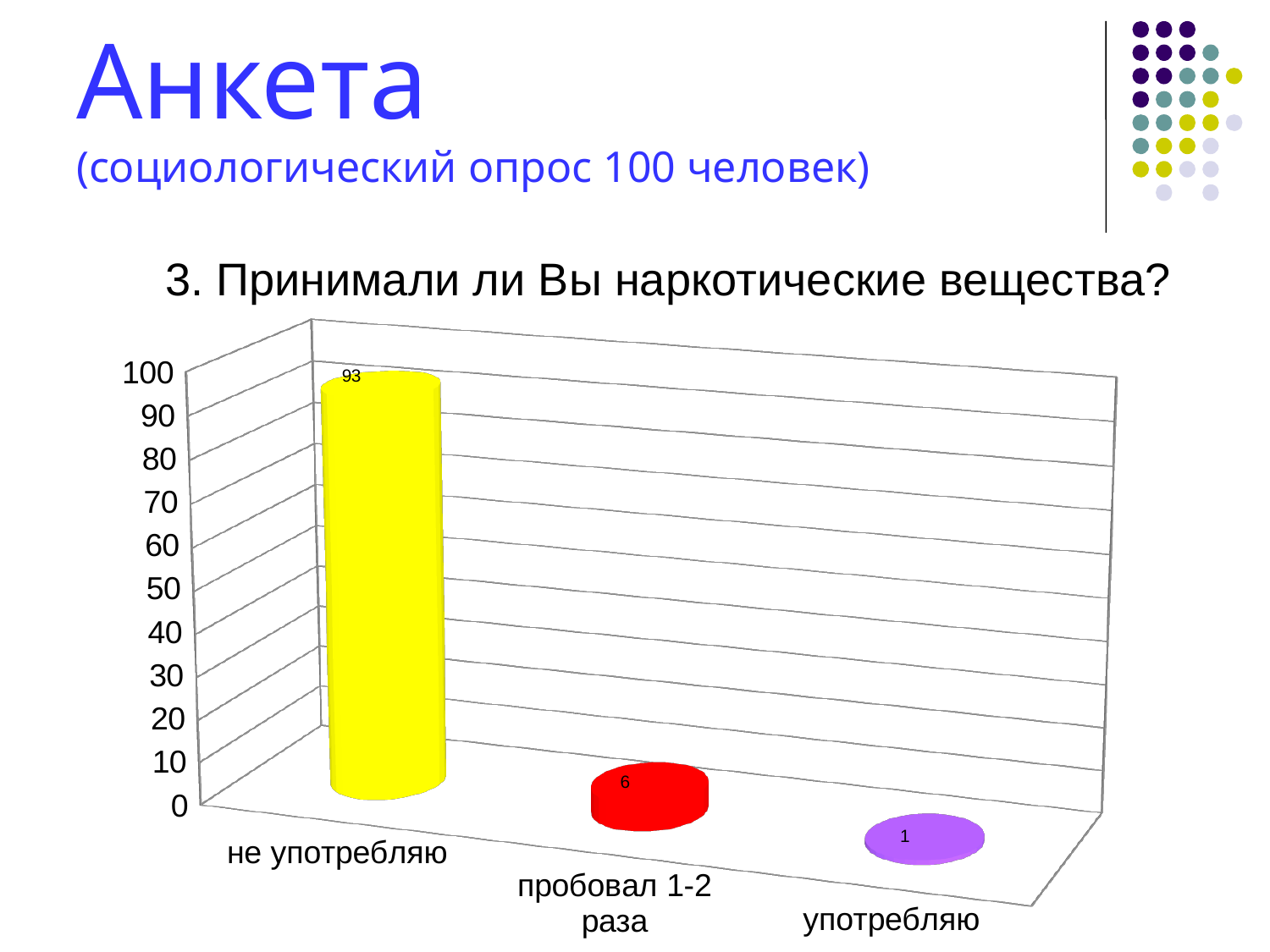
Is the value for "не употребляю" greater or less than 50? greater What colour is the bar for "не употребляю"? yellow Which category has the lowest value? употребляю How many categories are shown on the chart? 3 What is the difference between the values for "не употребляю" and "пробовал 1-2 раза"? 87 What is the difference between the values for "пробовал 1-2 раза" and "употребляю"? 5 Which is larger, the value for "пробовал 1-2 раза" or the value for "употребляю"? пробовал 1-2 раза Which category has the highest value? не употребляю What kind of chart is shown on the slide? bar chart What is the value for "употребляю"? 1 What is the value for "пробовал 1-2 раза"? 6 What is the value for "не употребляю"? 93